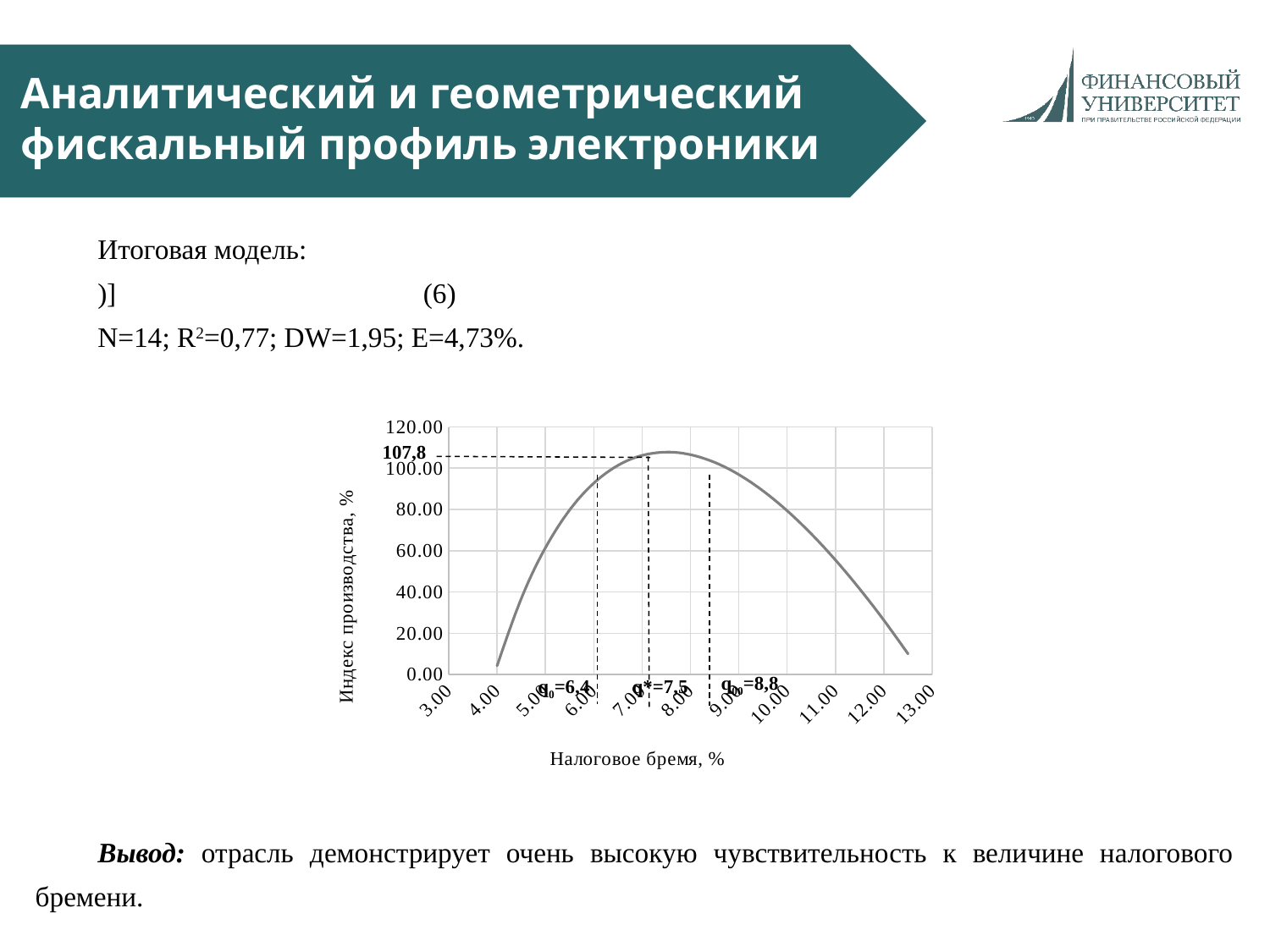
What is the title of the vertical axis of the chart? Индекс производства, % What kind of chart is shown on the slide? line chart Does the curve rise or fall as the tax burden increases from 4.00 to 7.00? rise How many tick labels are shown on the horizontal axis of the chart? 11 What value of q00 is marked by the right dashed line on the chart? 8,8 What is the title of the horizontal axis of the chart? Налоговое бремя, % Is the production index at a tax burden of 6.00 greater or less than 60.00? greater At what tax burden (q*) does the curve reach its peak, according to the label on the chart? 7,5 What value of q0 is marked by the left dashed line on the chart? 6,4 Does the curve rise or fall as the tax burden increases from 9.00 to 12.00? fall What is the maximum value of the production index marked on the chart? 107,8 What is the difference between the marked values q00=8,8 and q0=6,4? 2,4